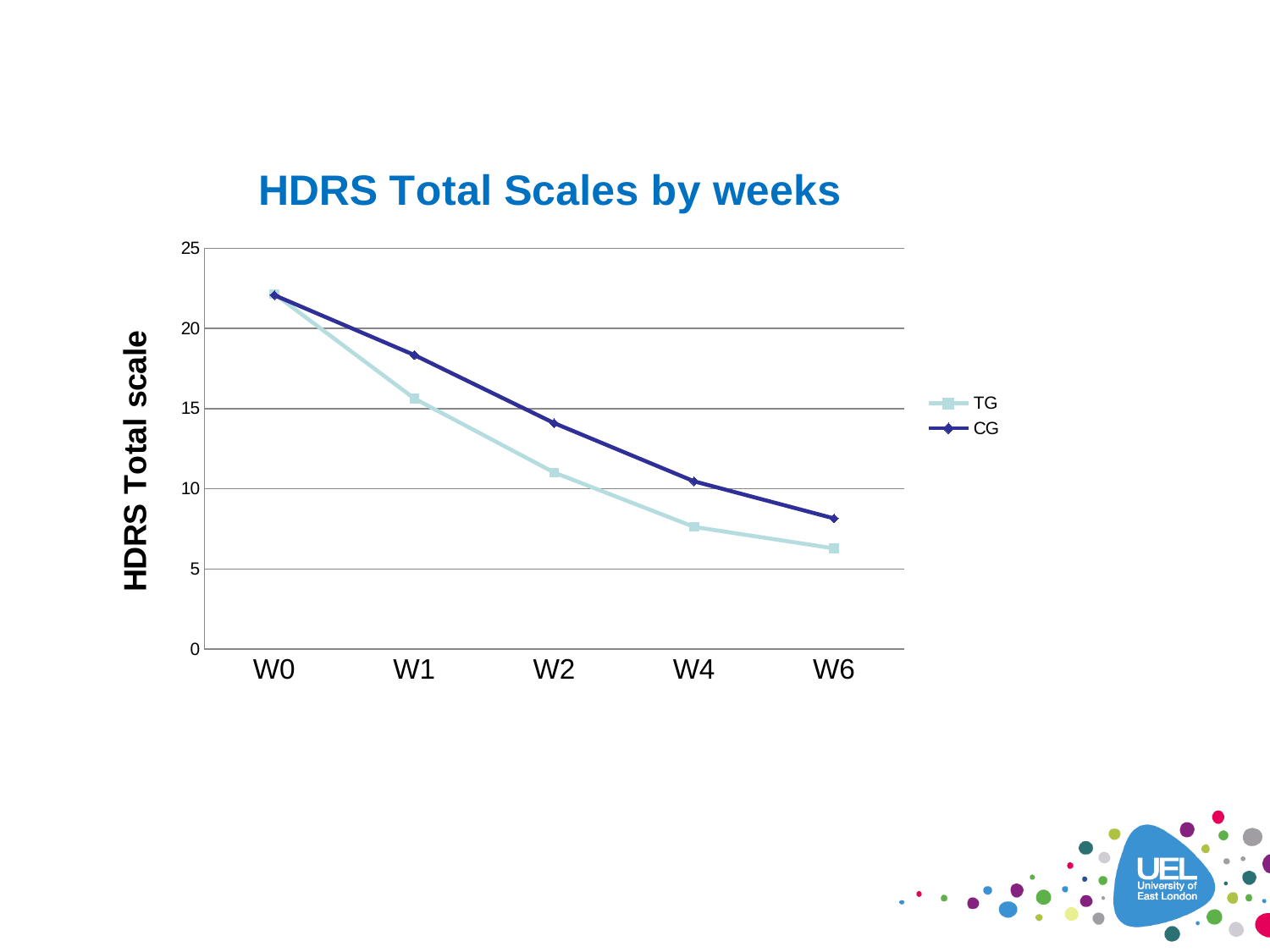
What kind of chart is shown on the slide? line chart What is the label of the y axis? HDRS Total scale What is the title of the chart? HDRS Total Scales by weeks At W2, which series has the higher value, TG or CG? CG How many series does the legend list? 2 Is the value for CG at W1 greater or less than 20? less How many week points are plotted along the x axis? 5 Do the TG values rise or fall from W0 to W6? fall At which week is the TG value highest? W0 Is the value for TG at W4 greater or less than 10? less At which week is the CG value lowest? W6 Do the CG values rise or fall from W0 to W6? fall